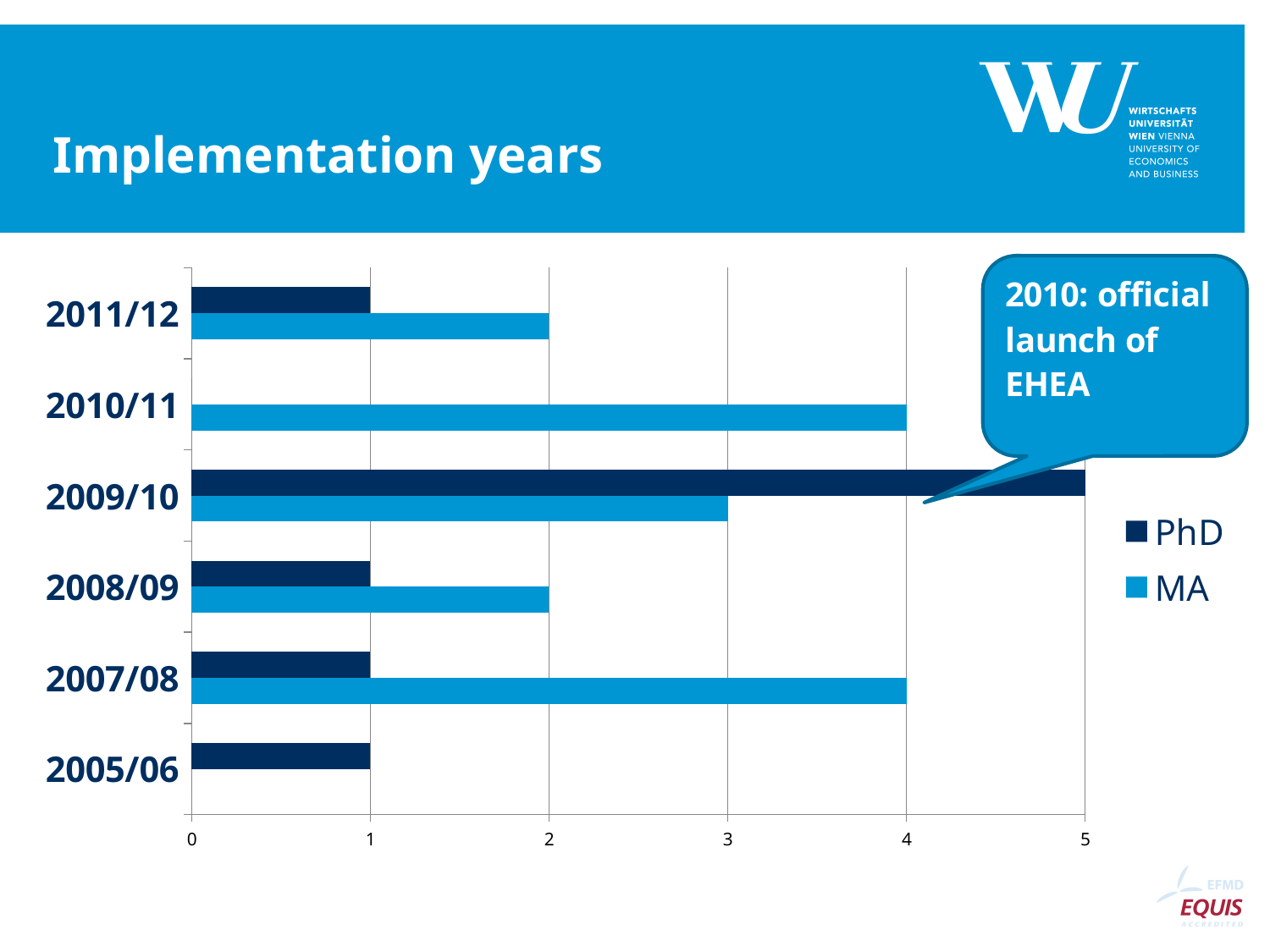
How many academic years are shown on the vertical axis? 6 What is the MA value for 2010/11? 4 Which is larger for 2007/08, the PhD value or the MA value? MA What kind of chart is shown on the slide? bar chart What is the MA value for 2011/12? 2 What is the title of the chart slide? Implementation years Which year has the highest PhD value? 2009/10 What is the difference between the PhD and MA values for 2009/10? 2 How many series does the legend list? 2 Is the PhD value for 2009/10 greater or less than 4? greater Which year has the lowest MA value among years with an MA bar? 2011/12 and 2008/09 (both 2) What is the PhD value for 2009/10? 5